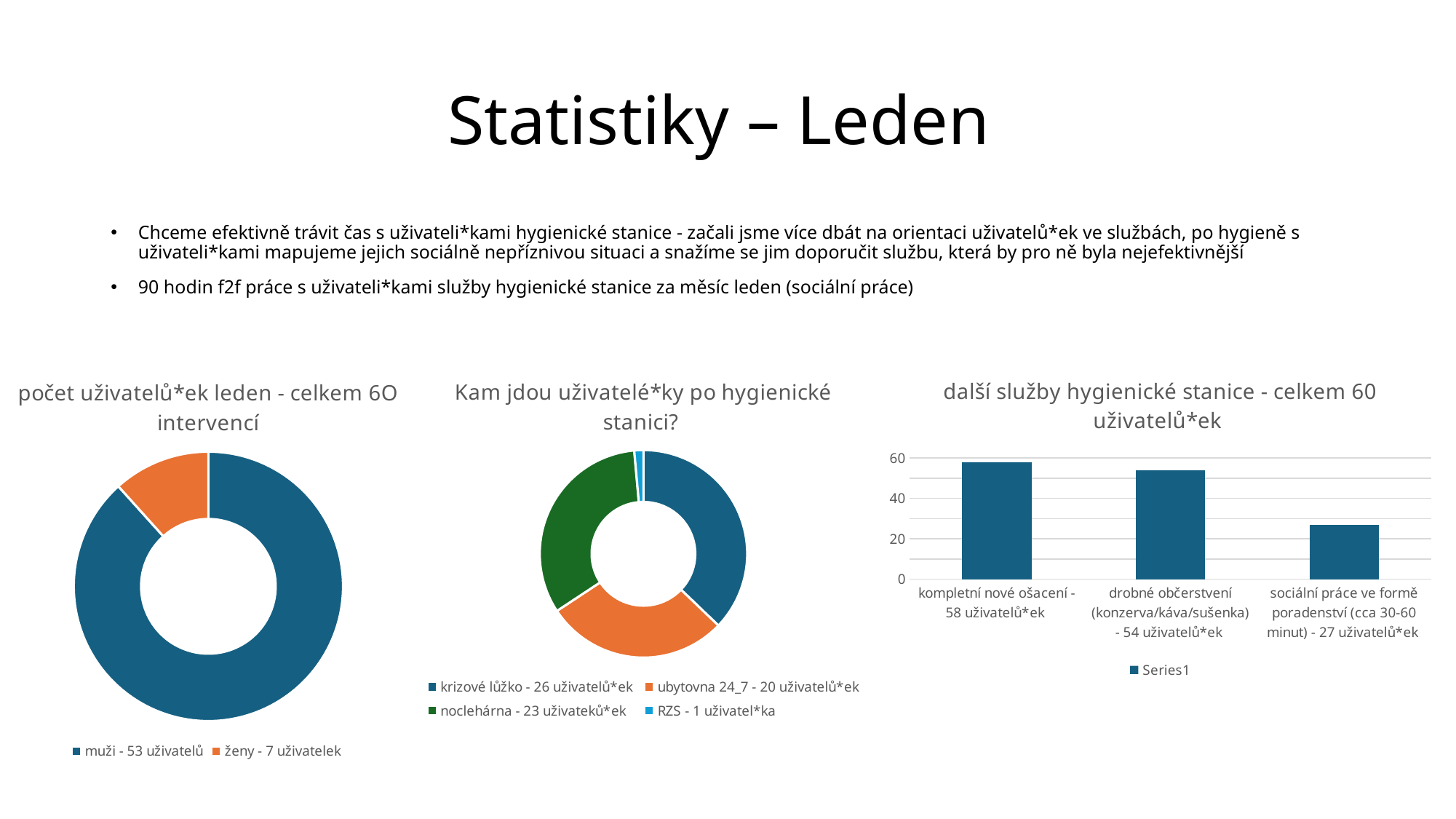
In the chart titled "další služby hygienické stanice - celkem 60 uživatelů*ek", how many users received kompletní nové ošacení? 58 uživatelů*ek In the chart titled "další služby hygienické stanice - celkem 60 uživatelů*ek", what kind of chart is shown? bar chart In the chart titled "počet uživatelů*ek leden - celkem 6O intervencí", how many users are women (ženy)? 7 uživatelek In the chart titled "počet uživatelů*ek leden - celkem 6O intervencí", how many users are men (muži)? 53 uživatelů In the chart titled "Kam jdou uživatelé*ky po hygienické stanici?", which has more users: ubytovna 24_7 or noclehárna? noclehárna In the chart titled "další služby hygienické stanice - celkem 60 uživatelů*ek", which service has the lowest number of users? sociální práce ve formě poradenství (cca 30-60 minut) In the chart titled "počet uživatelů*ek leden - celkem 6O intervencí", what kind of chart is shown? doughnut chart In the chart titled "Kam jdou uživatelé*ky po hygienické stanici?", how many categories does the legend list? 4 In the chart titled "Kam jdou uživatelé*ky po hygienické stanici?", how many users go to krizové lůžko? 26 uživatelů*ek In the chart titled "počet uživatelů*ek leden - celkem 6O intervencí", what is the difference between the number of men and the number of women? 46 In the chart titled "Kam jdou uživatelé*ky po hygienické stanici?", which destination has the most users? krizové lůžko In the chart titled "Kam jdou uživatelé*ky po hygienické stanici?", which destination has the fewest users? RZS